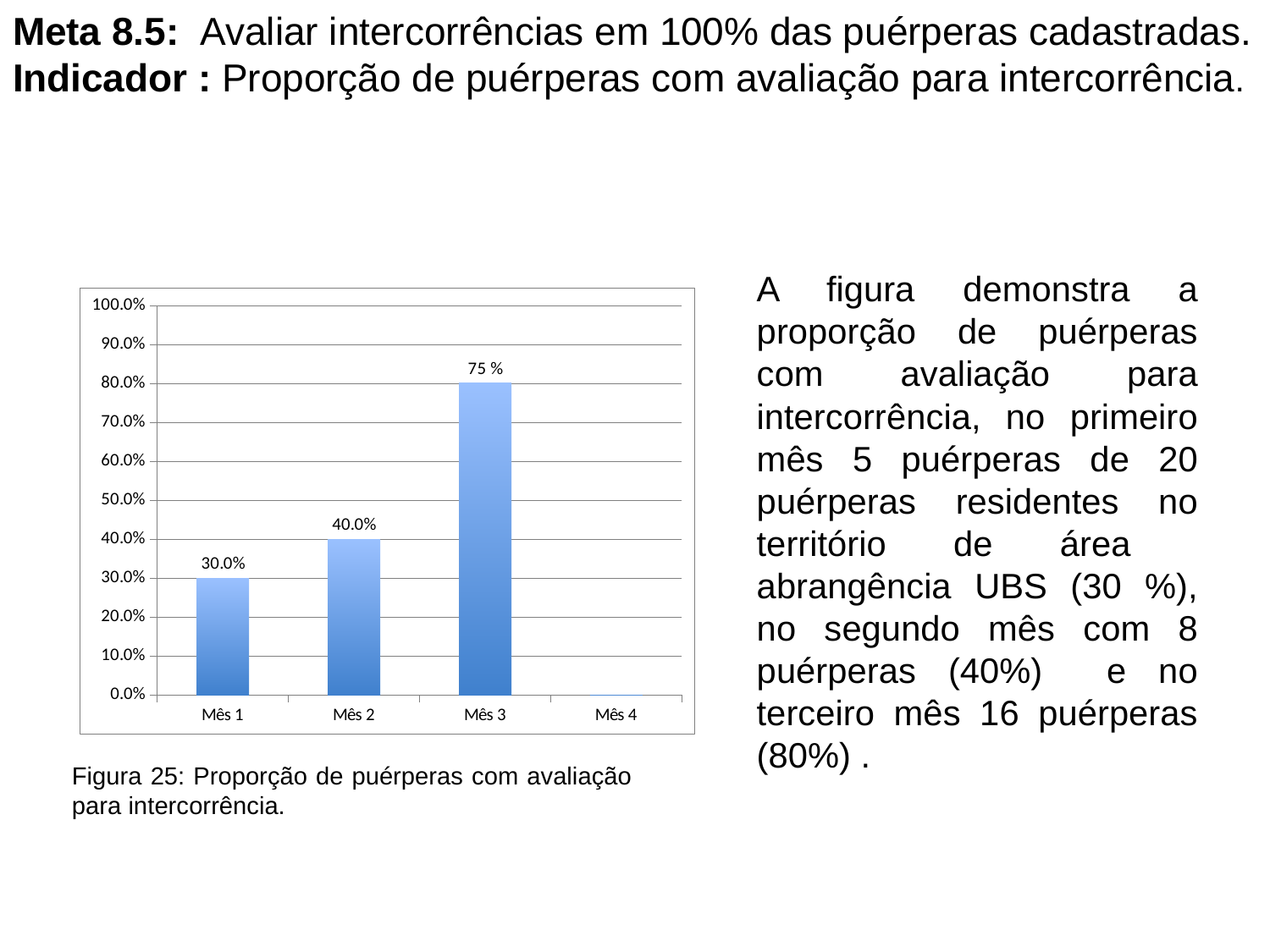
Which is larger, the value for Mês 1 or the value for Mês 2? Mês 2 What kind of chart is shown? bar chart How many month categories are shown on the x axis? 4 What is the difference between the values for Mês 2 and Mês 1? 10.0% Is the value for Mês 3 greater or less than 70.0%? greater What is the value for Mês 2? 40.0% Which month has the highest bar? Mês 3 Is the value for Mês 1 greater or less than 50.0%? less What is the highest value shown on the y axis? 100.0% What is the figure number given in the caption below the chart? Figura 25 Do the values rise or fall from Mês 1 to Mês 3? rise What is the value for Mês 1? 30.0%